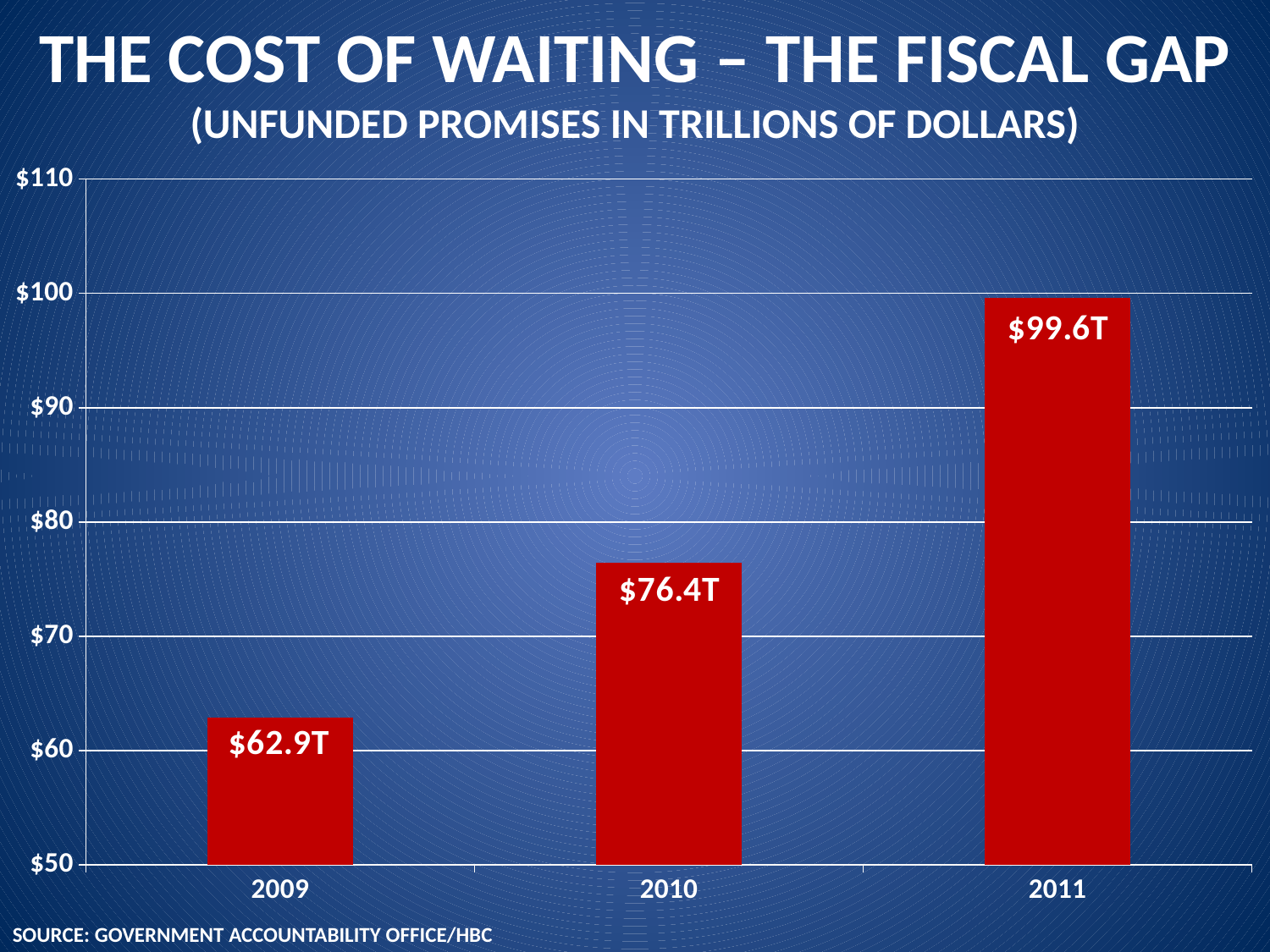
What kind of chart is shown on the slide? bar chart Which year has the lowest value? 2009 What is the value for 2010? $76.4T Which year has the highest value? 2011 Do the values rise or fall from 2009 to 2011? rise What is the value for 2011? $99.6T How many years are shown on the chart? 3 What is the difference between the values for 2010 and 2009? $13.5T Is the value for 2011 greater or less than $90? greater What is the value for 2009? $62.9T Which is larger, the value for 2010 or the value for 2011? 2011 What is the difference between the values for 2011 and 2009? $36.7T